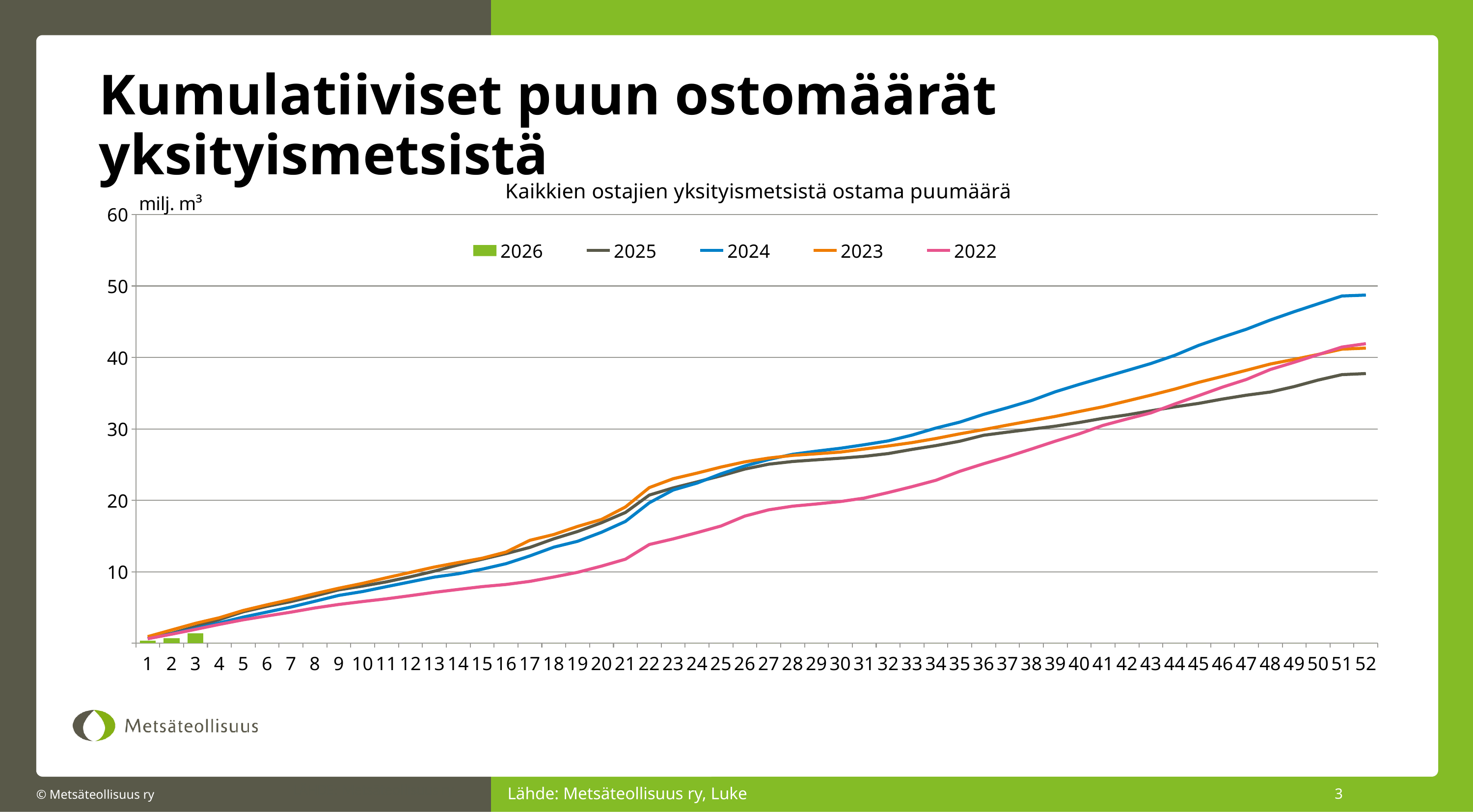
Among the line series, which has the lowest value at week 52? 2025 At week 30, which is larger: the value for 2023 or the value for 2022? 2023 Which series has the lowest value at week 40? 2022 Is the value for 2022 at week 26 greater or less than 20? less What unit is shown on the vertical axis of the chart? milj. m³ What is the title of the chart? Kaikkien ostajien yksityismetsistä ostama puumäärä How many series does the chart legend list? 5 Do the values of the 2024 series rise or fall from week 1 to week 52? rise Is the value for 2024 at week 52 greater or less than 40? greater Which series has the highest value at week 52? 2024 Is the value for 2025 at week 52 greater or less than 40? less How many weeks are shown along the x axis of the chart? 52